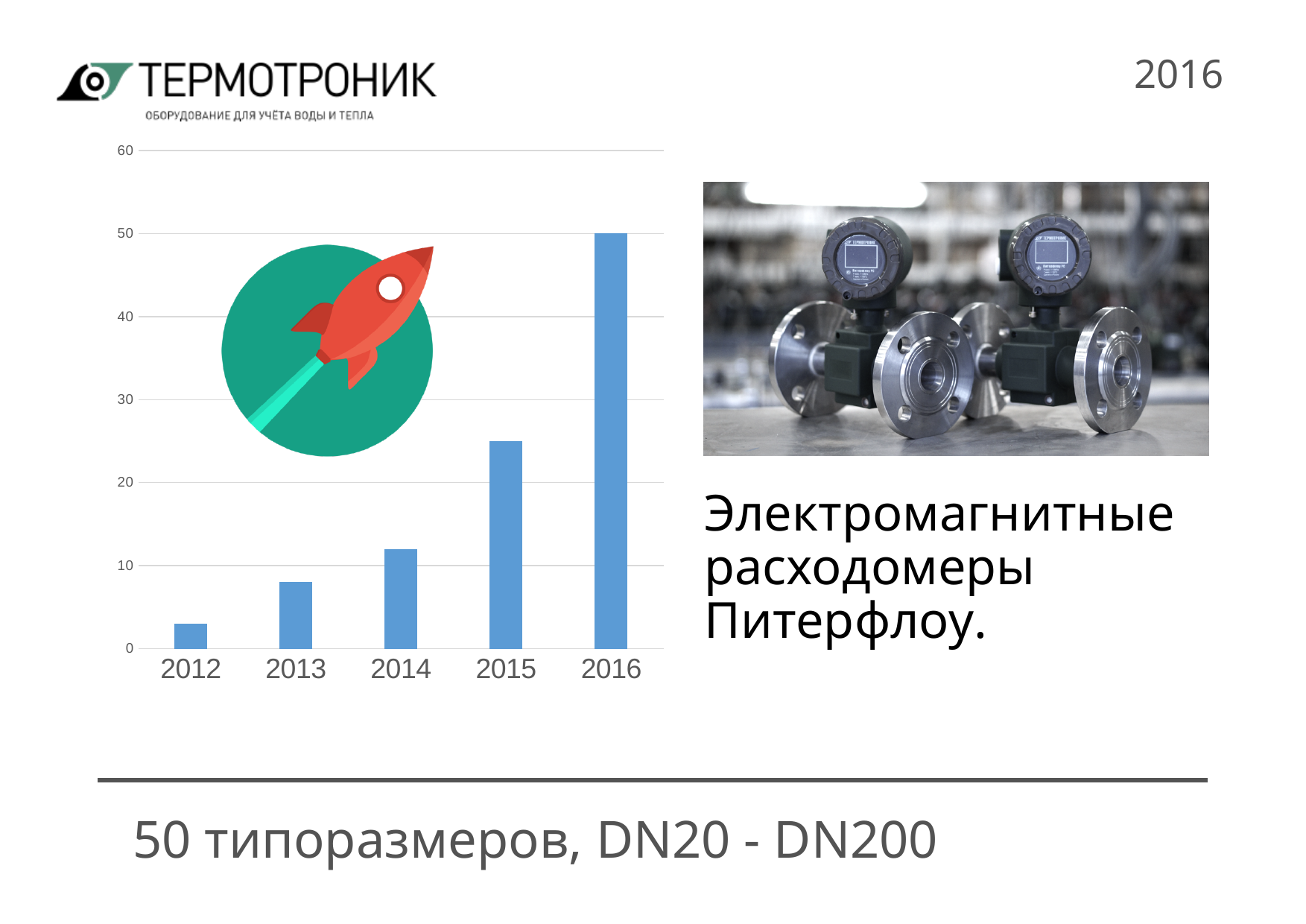
Is the value for 2015 greater or less than 20? greater Is the value for 2015 greater or less than 30? less Which year has the highest bar in the chart? 2016 Which year has the lowest bar in the chart? 2012 Do the values rise or fall from 2012 to 2016? rise Is the value for 2013 greater or less than 10? less How many years are shown on the x axis of the chart? 5 What is the value for 2016 in the chart? 50 What kind of chart is shown on the slide? bar chart Which is larger, the value for 2014 or the value for 2015? 2015